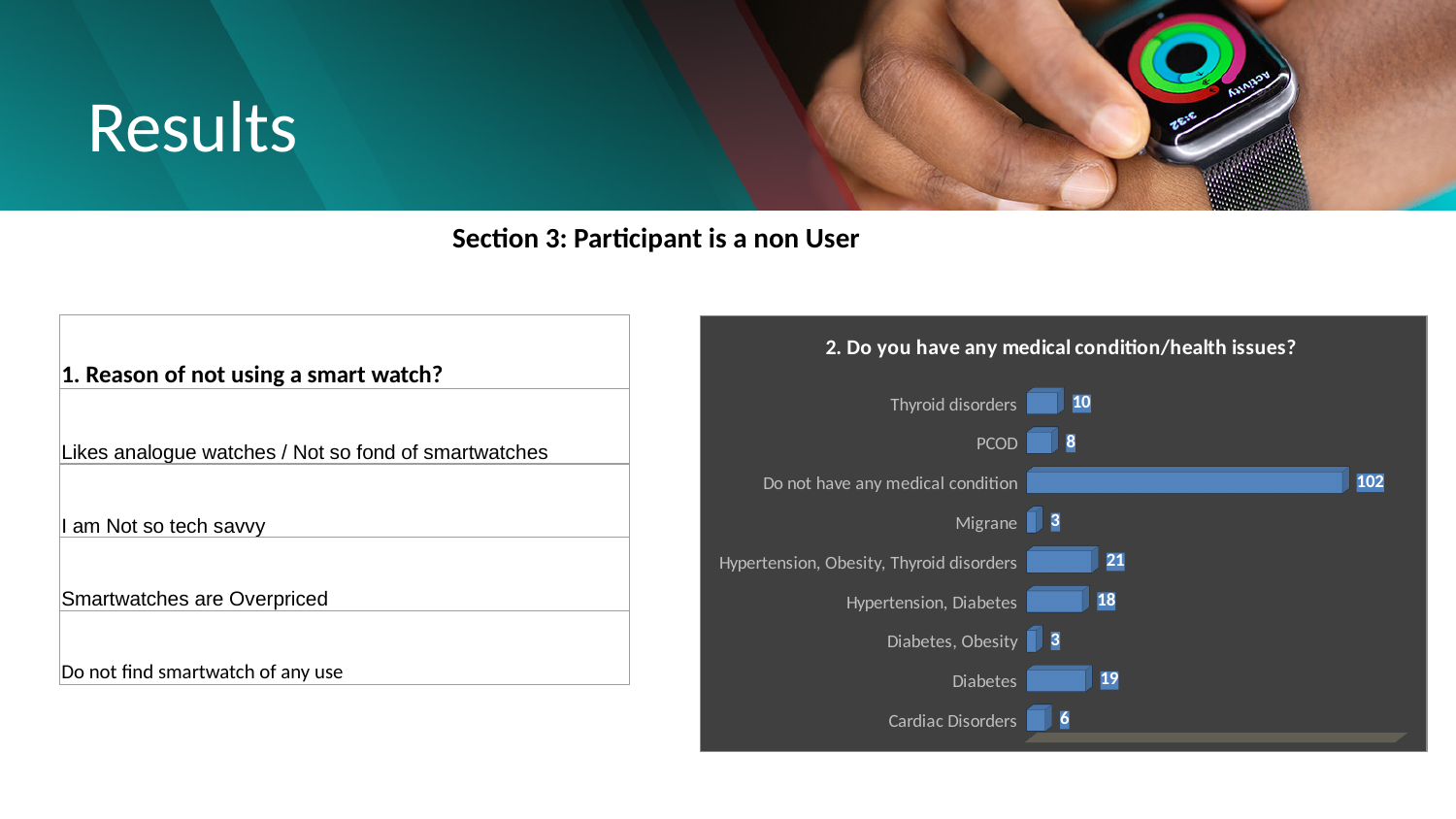
Which is larger, the value for 'Cardiac Disorders' or the value for 'Diabetes, Obesity'? Cardiac Disorders How many categories are shown in the chart? 9 Which is larger, the value for 'Thyroid disorders' or the value for 'PCOD'? Thyroid disorders Which category has the highest value? Do not have any medical condition What is the value for 'PCOD'? 8 What kind of chart is shown on the slide? Bar chart What is the value for 'Do not have any medical condition'? 102 What is the difference between the values for 'Diabetes' and 'Hypertension, Diabetes'? 1 What is the value for 'Cardiac Disorders'? 6 What is the value for 'Hypertension, Obesity, Thyroid disorders'? 21 What is the difference between the values for 'Thyroid disorders' and 'Migrane'? 7 What is the title of the chart? 2. Do you have any medical condition/health issues?